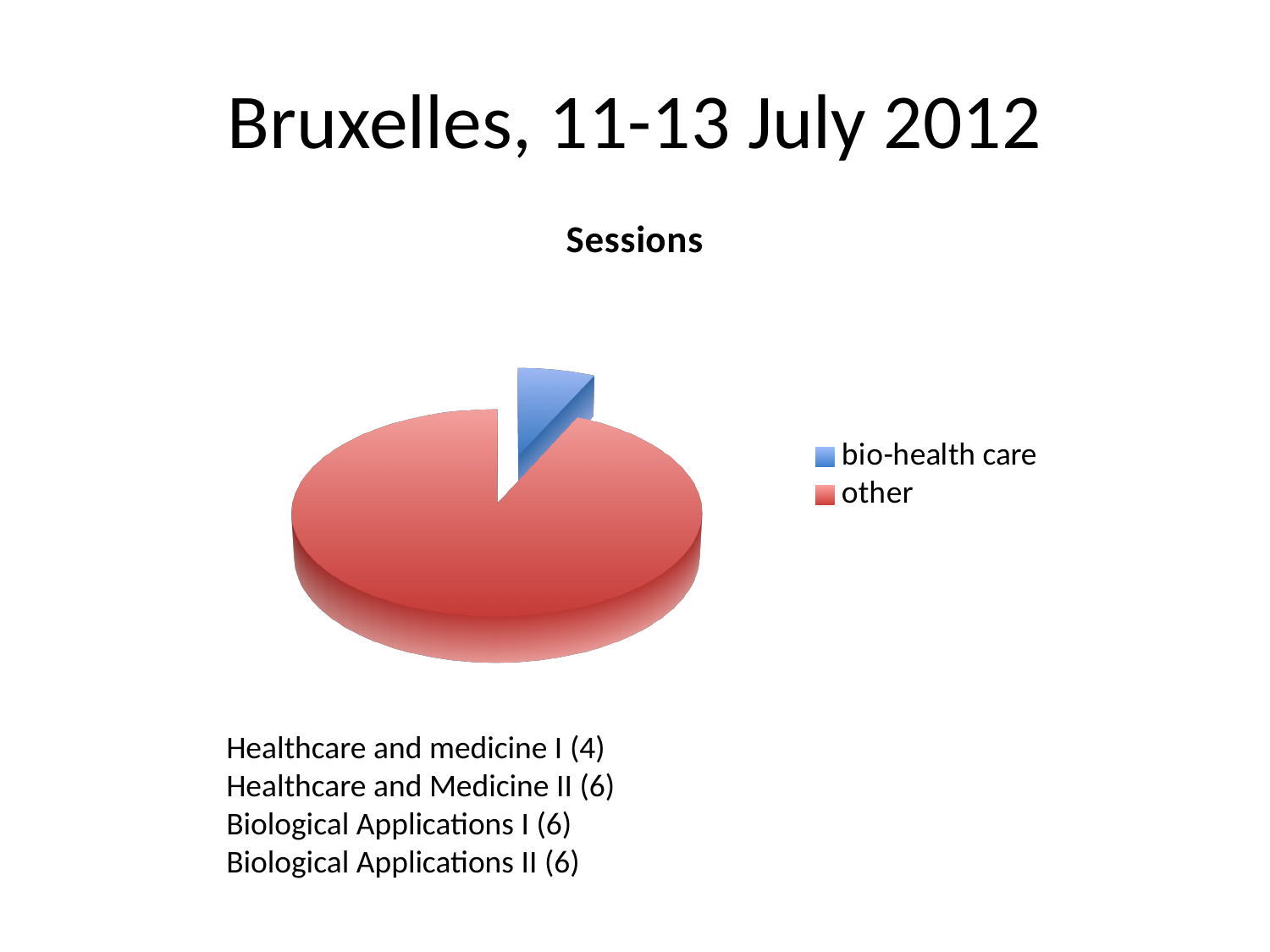
Which slice of the pie chart is the largest? other What is the title of the chart? Sessions What kind of chart is shown on the slide? pie chart How many entries does the chart legend list? 2 What colour is the bio-health care slice in the pie chart? blue Which is larger in the pie chart, bio-health care or other? other How many slices does the pie chart have? 2 Which slice of the pie chart is the smallest? bio-health care